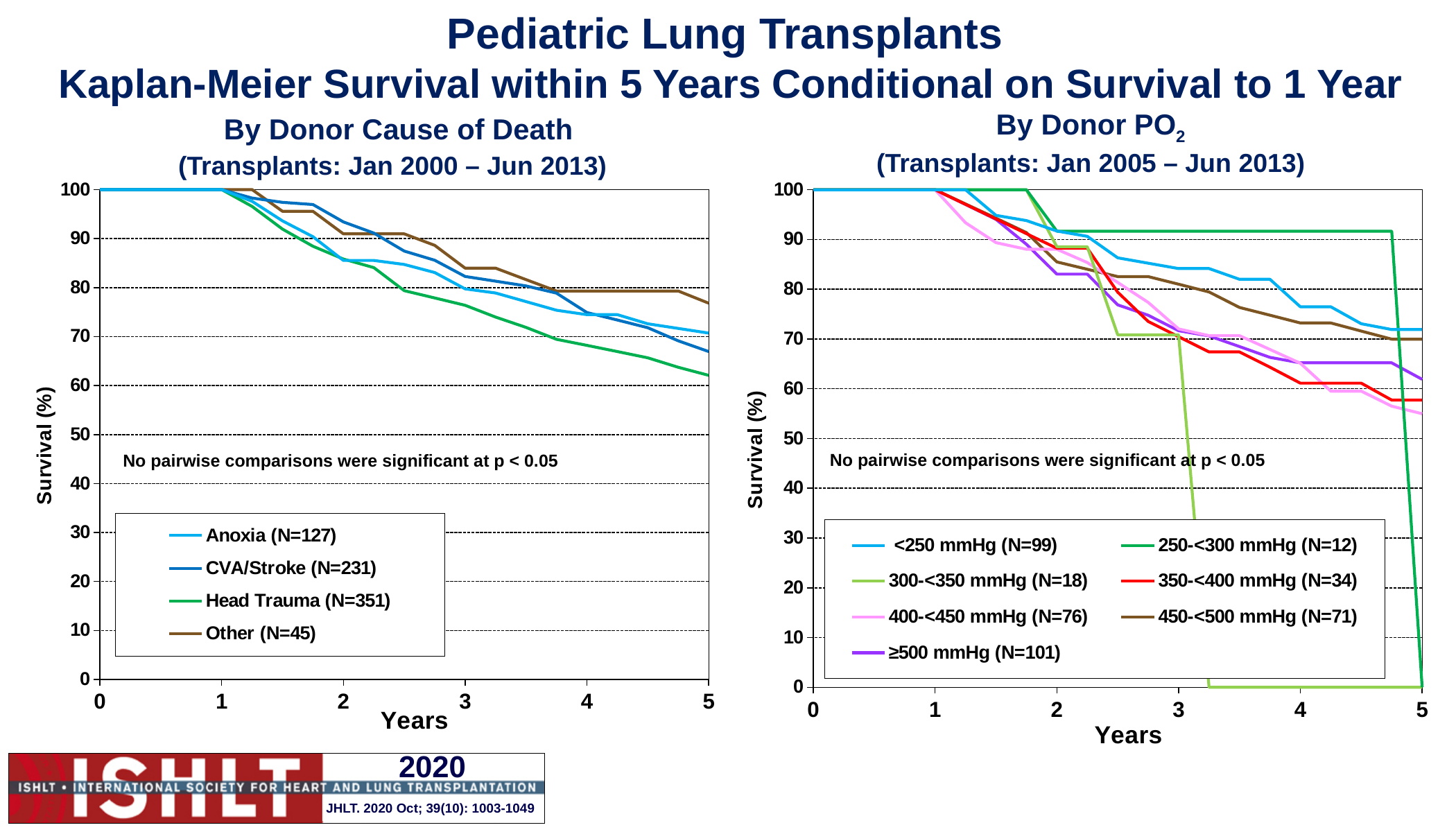
In the 'By Donor Cause of Death' chart, what is the N shown in the legend for CVA/Stroke? 231 In the 'By Donor Cause of Death' chart, is the survival for Head Trauma at 5 years greater or less than 70? less In the 'By Donor Cause of Death' chart, which series has the lowest survival at 5 years? Head Trauma How many series does the legend of the 'By Donor Cause of Death' chart list? 4 In the 'By Donor Cause of Death' chart, which has higher survival at 5 years, Anoxia or Head Trauma? Anoxia In the 'By Donor Cause of Death' chart, does the Head Trauma survival curve rise or fall as years increase? fall What kind of chart is the 'By Donor Cause of Death' chart on the left? line chart In the 'By Donor PO2' chart, is the survival for 300-<350 mmHg at 4 years greater or less than 10? less In the 'By Donor PO2' chart, what is the N shown in the legend for ≥500 mmHg? 101 In the 'By Donor Cause of Death' chart, is the survival for Other at 5 years greater or less than 70? greater How many series does the legend of the 'By Donor PO2' chart list? 7 In the 'By Donor PO2' chart, which series has the highest survival at 4 years? 250-<300 mmHg